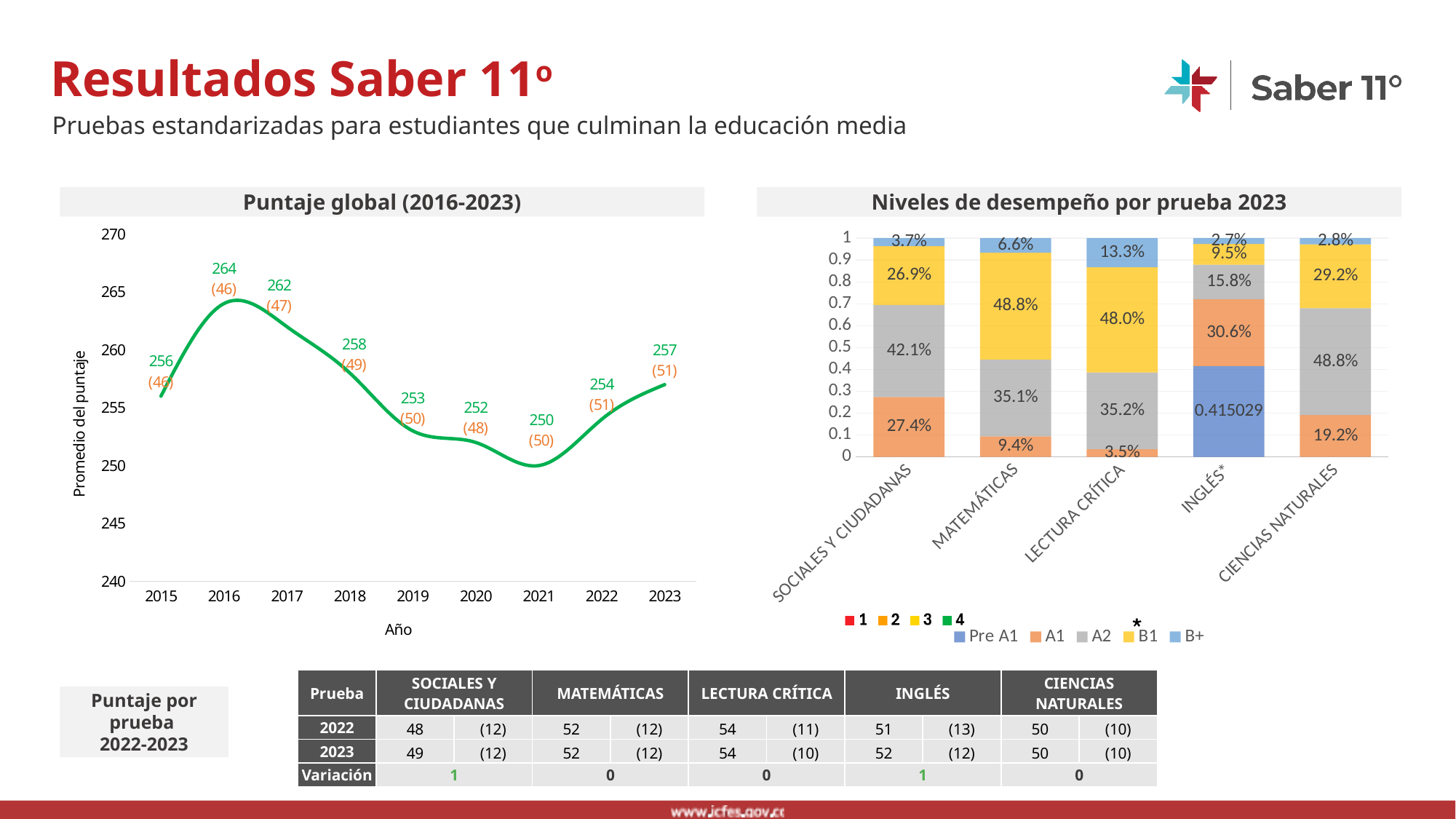
In the 'Niveles de desempeño por prueba 2023' chart, what percentage is shown for the yellow segment of MATEMÁTICAS? 48.8% What kind of chart is 'Niveles de desempeño por prueba 2023'? Stacked bar chart In the 'Niveles de desempeño por prueba 2023' chart, which has the larger gray segment: SOCIALES Y CIUDADANAS or CIENCIAS NATURALES? CIENCIAS NATURALES In the 'Puntaje global (2016-2023)' chart, how many years are plotted on the x axis? 9 In the 'Puntaje global (2016-2023)' chart, which year has the lowest average score? 2021 In the 'Niveles de desempeño por prueba 2023' chart, how many tests (categories) are shown on the x axis? 5 In the 'Niveles de desempeño por prueba 2023' chart, what percentage is shown for the top blue segment of LECTURA CRÍTICA? 13.3% In the 'Puntaje global (2016-2023)' chart, which year has the highest average score? 2016 In the 'Puntaje global (2016-2023)' chart, do the scores rise or fall from 2016 to 2021? Fall In the 'Puntaje global (2016-2023)' chart, what is the difference between the 2023 score and the 2021 score? 7 In the 'Puntaje global (2016-2023)' chart, what is the average score shown for 2016? 264 What kind of chart is 'Puntaje global (2016-2023)'? Line chart